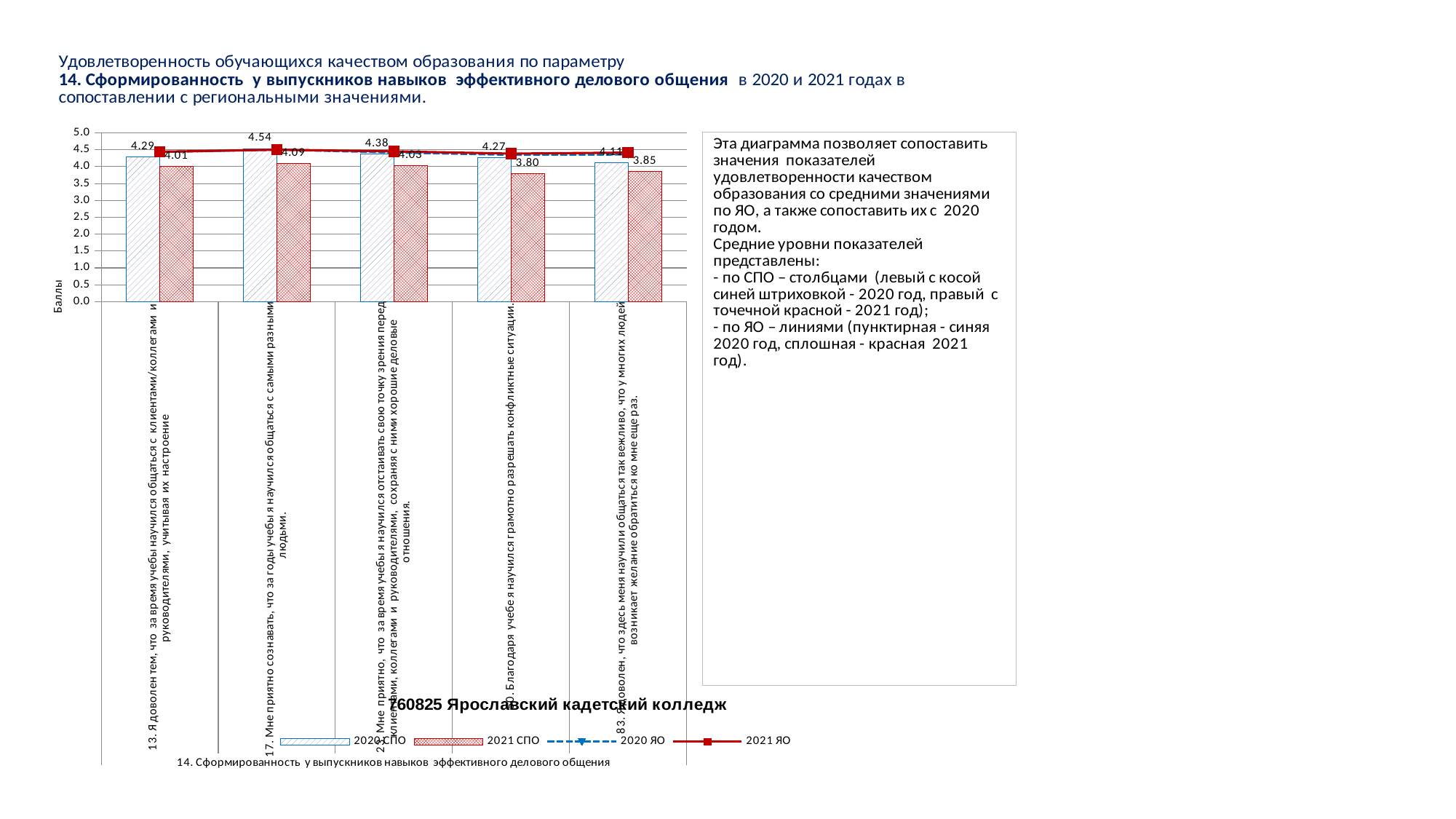
For category 13, what is the difference between the 2020 СПО and 2021 СПО values? 0.28 For category 83, how much higher is the 2020 СПО value than the 2021 СПО value? 0.26 How many series does the legend list? 4 What is the 2021 СПО value for category 17 ("Мне приятно сознавать, что за годы учебы я научился общаться с самыми разными людьми")? 4.09 What is the label of the vertical axis? Баллы Which category has the lowest 2021 СПО value? Благодаря учебе я научился грамотно разрешать конфликтные ситуации (3.80) How many categories are shown on the x axis? 5 Is the 2021 ЯО line value for category 13 greater or less than 4.0? greater What is the 2020 СПО value for category 13 ("Я доволен тем, что за время учебы научился общаться с клиентами/коллегами и руководителями...")? 4.29 What is the 2021 СПО value for category 83 ("Я доволен, что здесь меня научили общаться так вежливо...")? 3.85 Which category has the highest 2020 СПО value? 17. Мне приятно сознавать, что за годы учебы я научился общаться с самыми разными людьми (4.54) Which is larger: the 2020 СПО value for category 17 or for category 83? Category 17 (4.54)